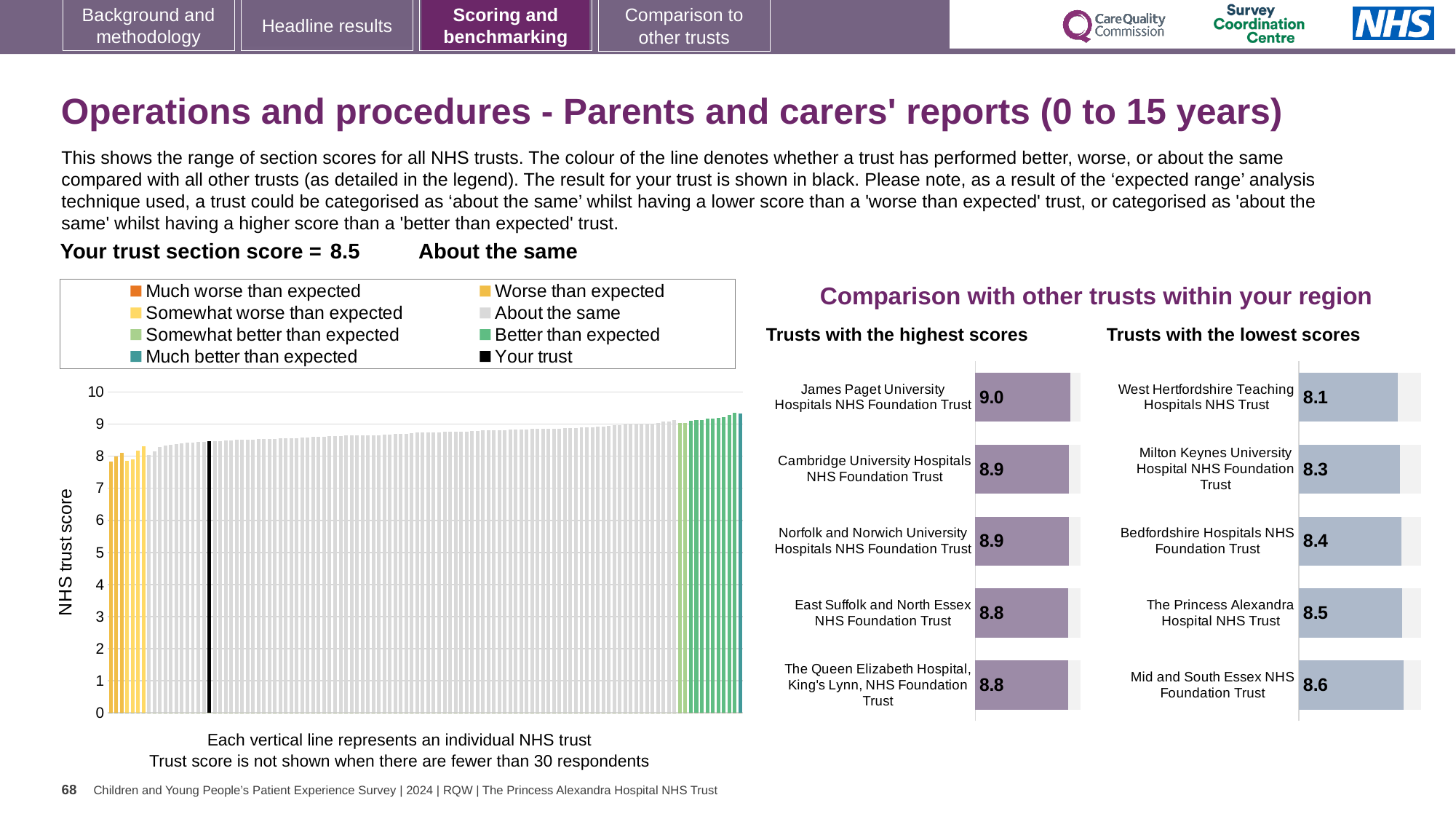
In the large 'NHS trust score' chart on the left, what is the section score for your trust (the black bar)? 8.5 In the 'Trusts with the lowest scores' chart, which trust has the lowest score? West Hertfordshire Teaching Hospitals NHS Trust What is the difference between the score of James Paget University Hospitals NHS Foundation Trust in the highest scores chart and West Hertfordshire Teaching Hospitals NHS Trust in the lowest scores chart? 0.9 In the 'Trusts with the highest scores' chart, what is the score for James Paget University Hospitals NHS Foundation Trust? 9.0 In the large 'NHS trust score' chart on the left, do the bar values rise or fall from left to right? rise In the 'Trusts with the lowest scores' chart, what is the score for West Hertfordshire Teaching Hospitals NHS Trust? 8.1 In the 'Trusts with the highest scores' chart, which trust has the highest score? James Paget University Hospitals NHS Foundation Trust In the 'Trusts with the lowest scores' chart, what is the score for Bedfordshire Hospitals NHS Foundation Trust? 8.4 How many entries does the legend above the large 'NHS trust score' chart list? 8 Which has the larger score: Cambridge University Hospitals NHS Foundation Trust in the highest scores chart or Bedfordshire Hospitals NHS Foundation Trust in the lowest scores chart? Cambridge University Hospitals NHS Foundation Trust In the large 'NHS trust score' chart on the left, are the values of the rightmost green bars greater or less than 9? greater How many trusts are listed in the 'Trusts with the lowest scores' chart? 5